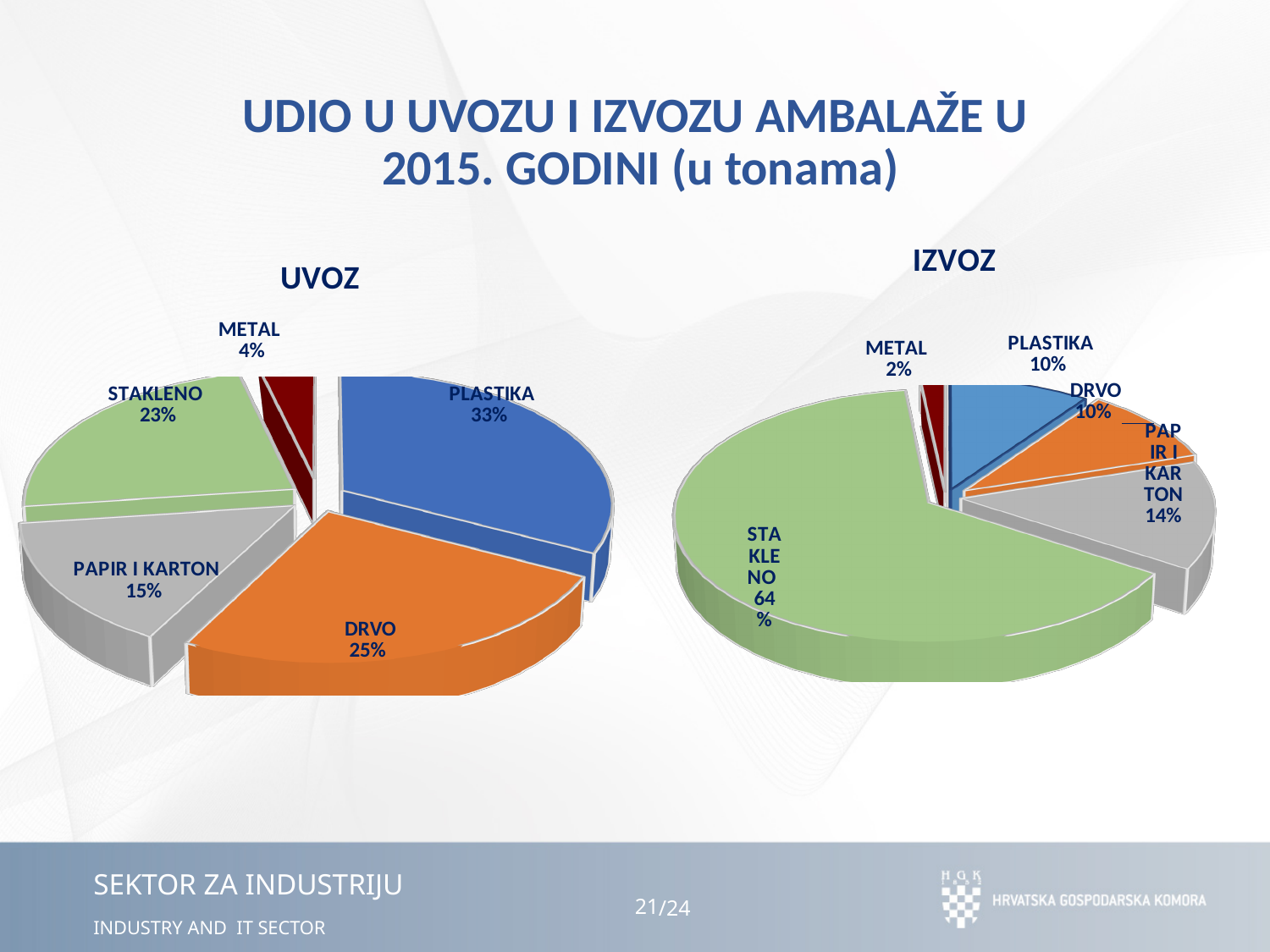
In the IZVOZ chart, what share does PAPIR I KARTON have? 14% In the IZVOZ chart, what share does STAKLENO have? 64% How many categories are shown in the IZVOZ chart? 5 In the IZVOZ chart, which category has the smallest share? METAL In the UVOZ chart, what share does STAKLENO have? 23% In the UVOZ chart, what is the difference between the shares of DRVO and PAPIR I KARTON? 10% Which is larger: the share of METAL in the UVOZ chart or in the IZVOZ chart? UVOZ In the UVOZ chart, what share does PLASTIKA have? 33% In the IZVOZ chart, which category has the largest share? STAKLENO In the UVOZ chart, which category has the largest share? PLASTIKA What type of chart is the UVOZ chart? Pie chart In the UVOZ chart, which category has the smallest share? METAL